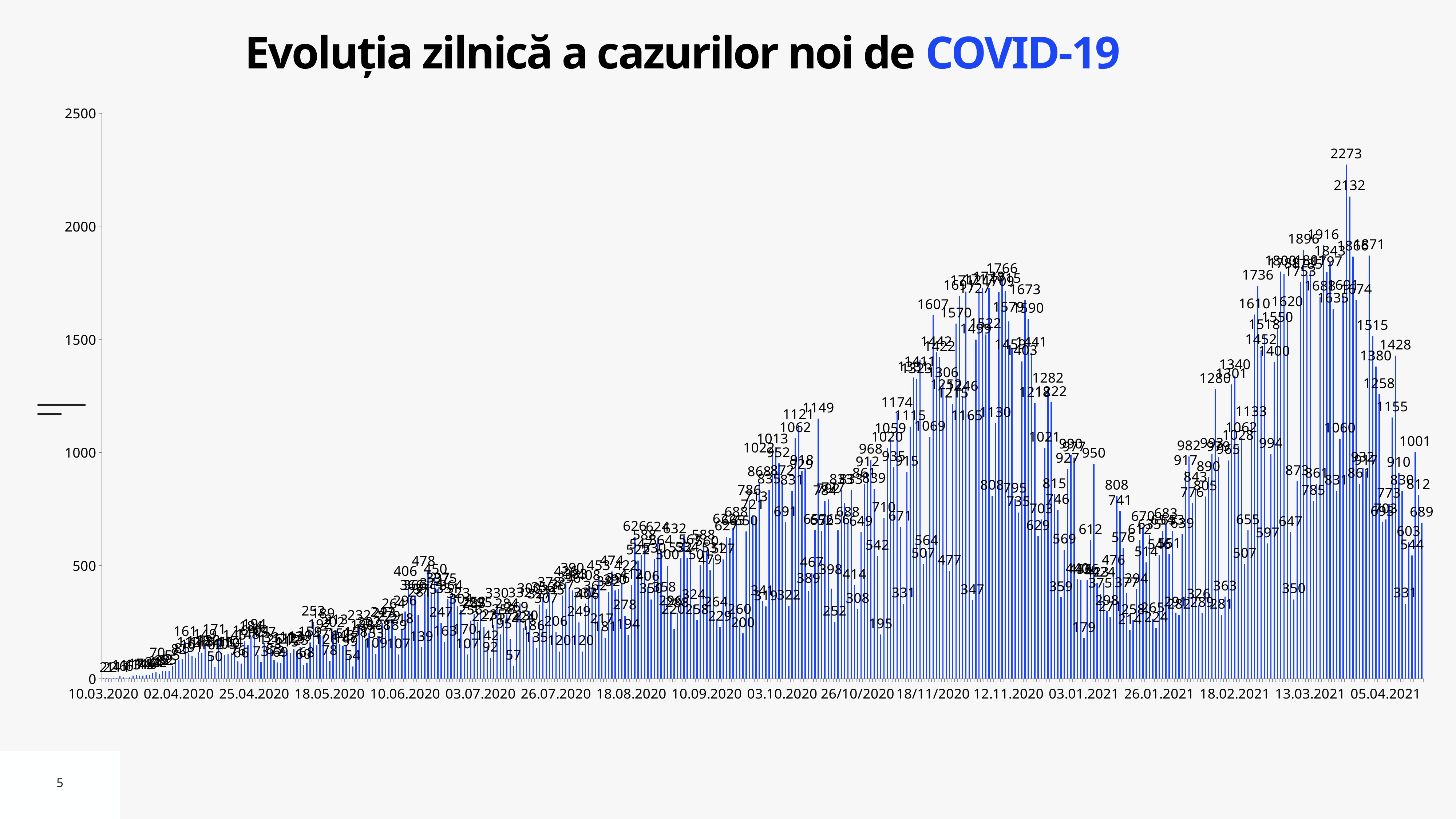
What is the highest daily value labelled on the chart? 2273 What is the last date label on the x axis? 05.04.2021 Is the highest bar on the chart greater or less than 2000? greater What is the second-highest value labelled near the peak of the chart? 2132 How many date labels are shown along the x axis? 18 Is the bar labelled 2132 greater or less than 2000? greater What kind of chart is shown on the slide? bar chart Do the daily values generally rise or fall from the start of the x axis to the end? rise What is the first date label on the x axis? 10.03.2020 What is the topmost value shown on the y axis? 2500 What is the title of the chart? Evoluția zilnică a cazurilor noi de COVID-19 Which is larger, the bar labelled 2273 or the bar labelled 2132? 2273